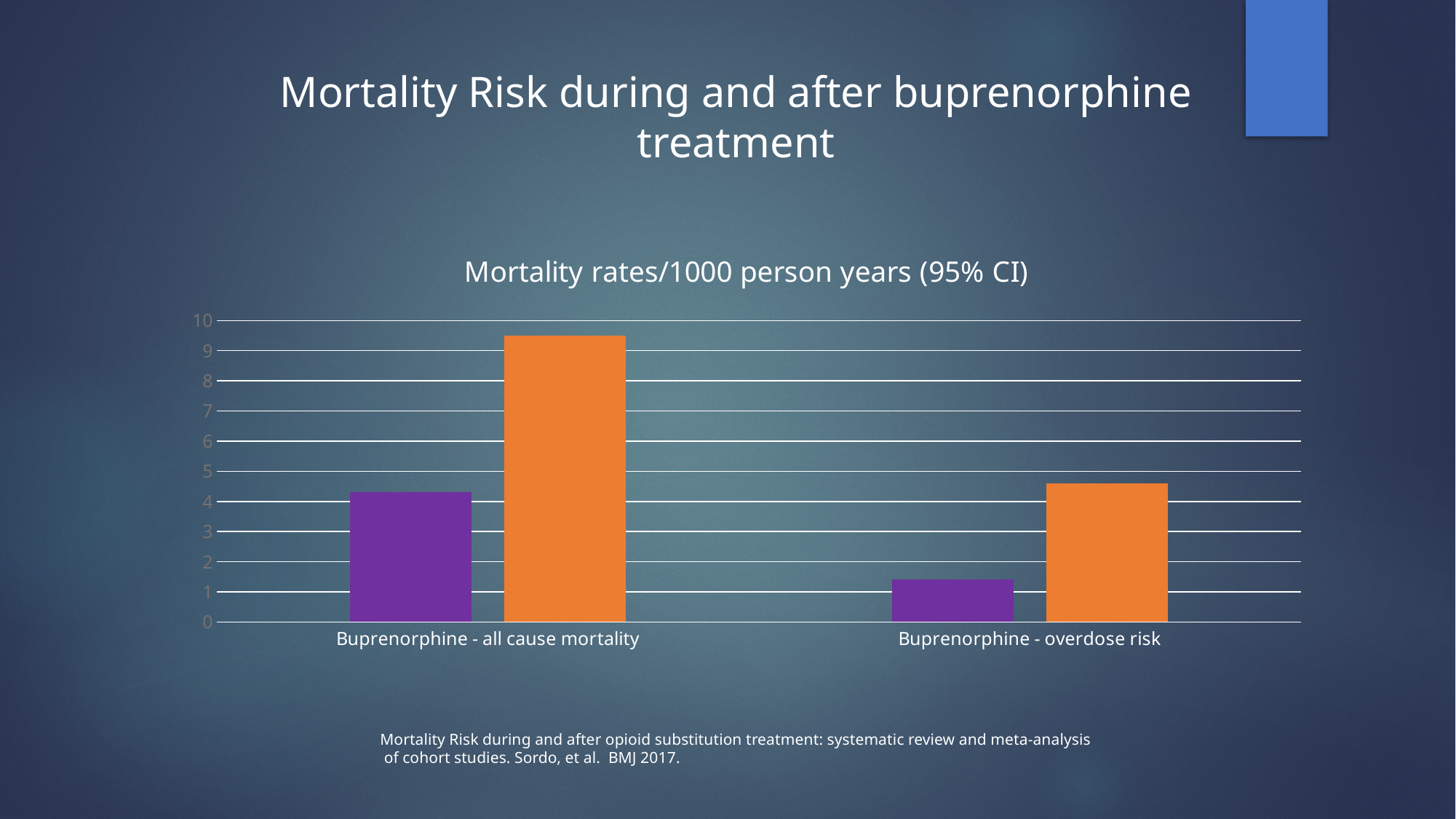
Is the value of the purple bar for Buprenorphine - all cause mortality greater or less than 5? less Is the value of the purple bar for Buprenorphine - overdose risk greater or less than 2? less How many bars are plotted in the chart in total? 4 Is the value of the orange bar for Buprenorphine - all cause mortality greater or less than 9? greater Which bar is the tallest in the chart? the orange bar for Buprenorphine - all cause mortality What is the title of the chart? Mortality rates/1000 person years (95% CI) Which bar is the shortest in the chart? the purple bar for Buprenorphine - overdose risk How many categories are shown on the x axis of the chart? 2 What is the highest value shown on the y axis of the chart? 10 What kind of chart is shown on the slide? bar chart For Buprenorphine - overdose risk, which bar is taller, the purple one or the orange one? the orange one